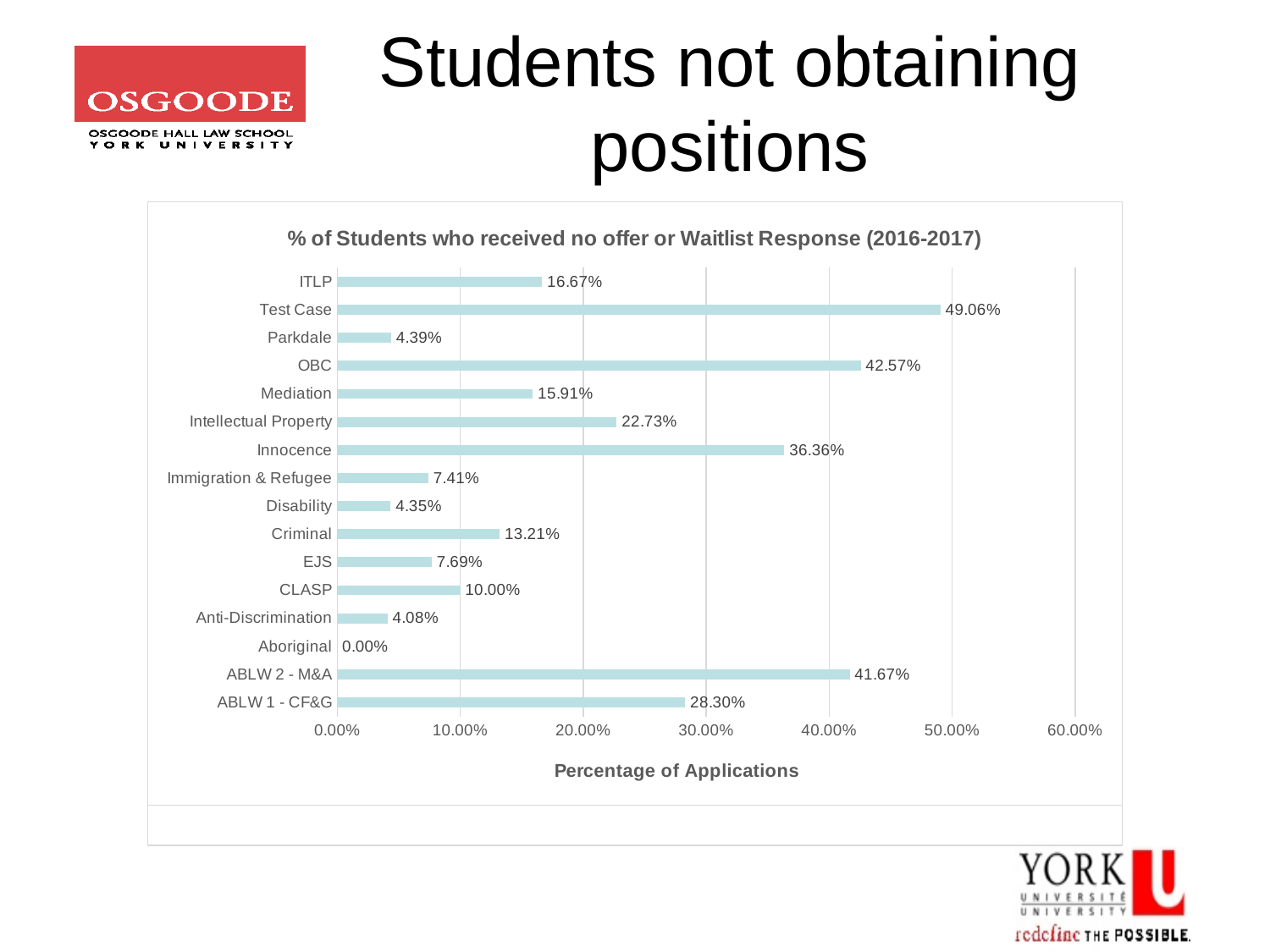
Which is larger, the value for OBC or the value for ABLW 2 - M&A? OBC What is the value for ABLW 1 - CF&G? 28.30% What kind of chart is this? Bar chart What is the title of the x axis? Percentage of Applications Which category has the highest value? Test Case How many categories are shown in the chart? 16 Is the value for Intellectual Property greater or less than 20.00%? greater What is the value for Immigration & Refugee? 7.41% What is the difference between the values for Test Case and OBC? 6.49% What is the value for Test Case? 49.06% What is the value for Innocence? 36.36% Which category has the lowest value? Aboriginal